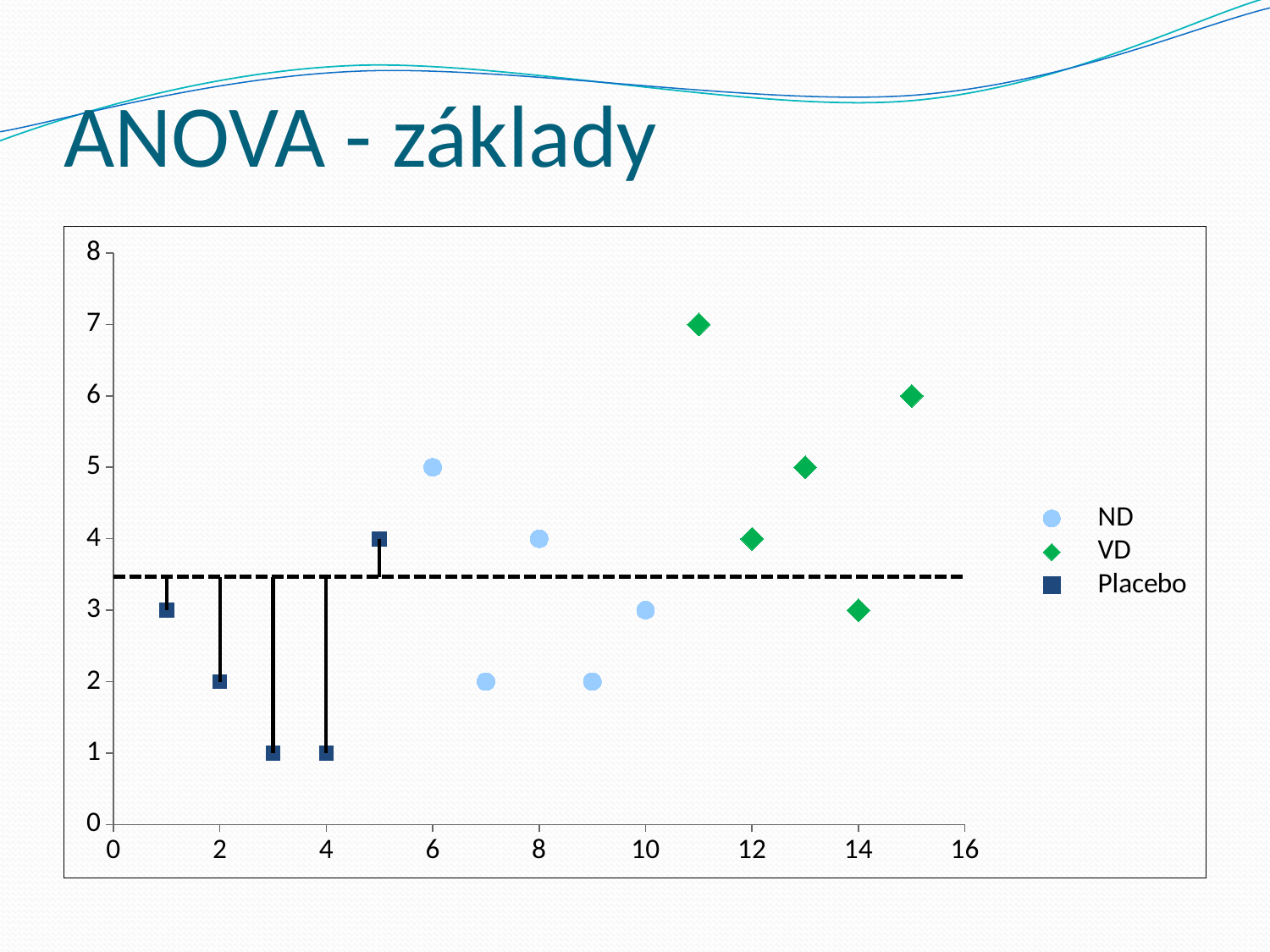
How many points are plotted for the VD series? 5 Which series are listed in the legend? ND, VD, Placebo What is the difference between the y value of the VD point at x = 11 and the Placebo point at x = 3? 6 What kind of chart is shown on the slide? scatter chart What is the y value of the Placebo point at x = 5? 4 Which series contains the highest plotted point on the chart? VD What is the y value of the ND point at x = 6? 5 Which is larger: the y value of the ND point at x = 8 or the VD point at x = 14? ND point at x = 8 How many series does the legend list? 3 What is the lowest y value reached by any Placebo point? 1 What is the y value of the VD point at x = 11? 7 Which series is drawn with green diamond markers? VD